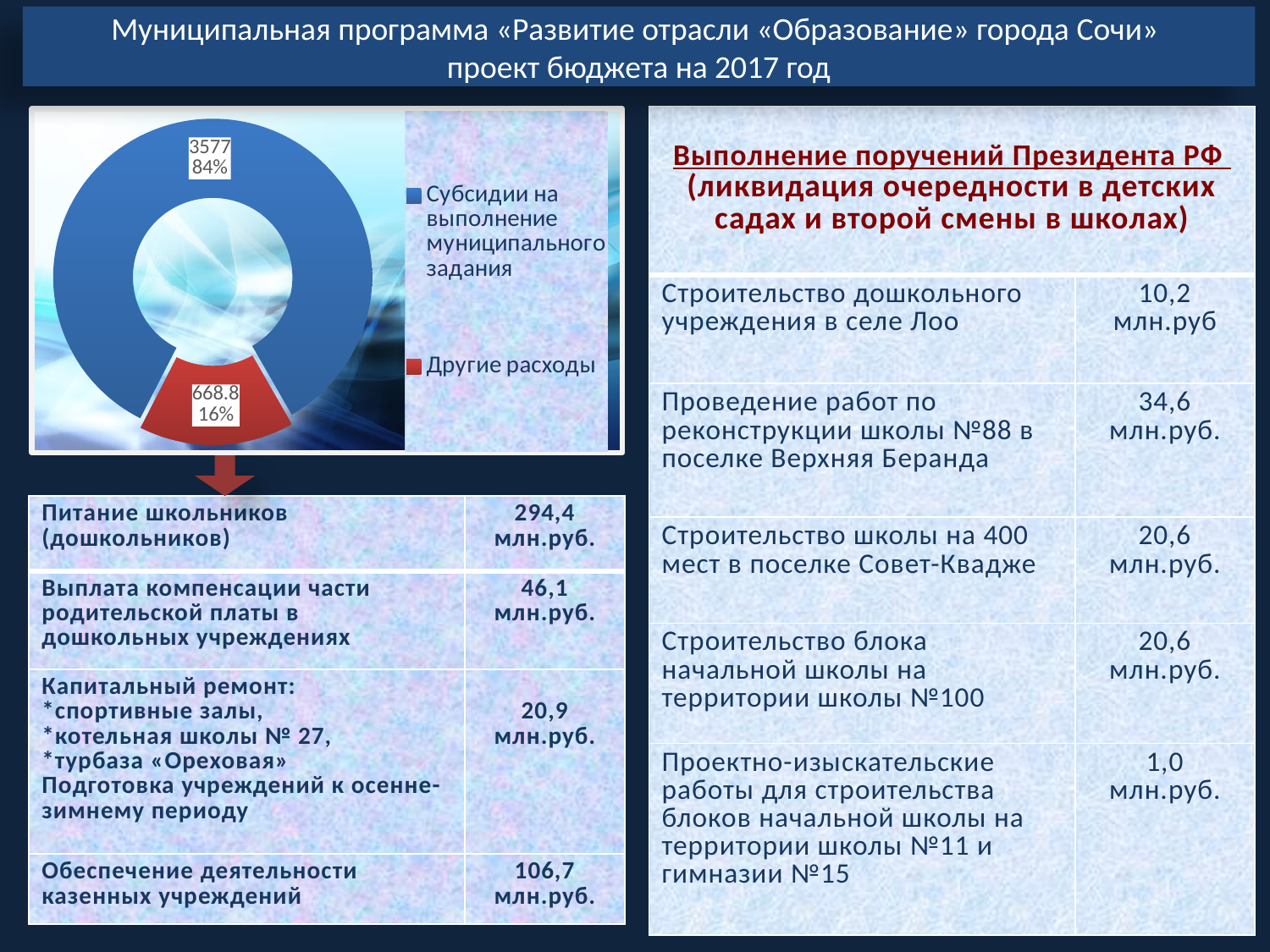
Which slice of the doughnut chart is the largest? Субсидии на выполнение муниципального задания How many slices does the doughnut chart have? 2 What share of the doughnut chart does 'Другие расходы' represent? 16% In the doughnut chart, which is larger: 'Субсидии на выполнение муниципального задания' or 'Другие расходы'? Субсидии на выполнение муниципального задания Which slice of the doughnut chart is the smallest? Другие расходы What is the difference between the values of 'Субсидии на выполнение муниципального задания' and 'Другие расходы' in the doughnut chart? 2908.2 What kind of chart is shown on the left of the slide? Doughnut chart What share of the doughnut chart does 'Субсидии на выполнение муниципального задания' represent? 84% What value is shown for the 'Субсидии на выполнение муниципального задания' slice of the doughnut chart? 3577 What value is shown for the 'Другие расходы' slice of the doughnut chart? 668.8 How many entries does the legend of the doughnut chart list? 2 What colour is the 'Другие расходы' slice in the doughnut chart? Red